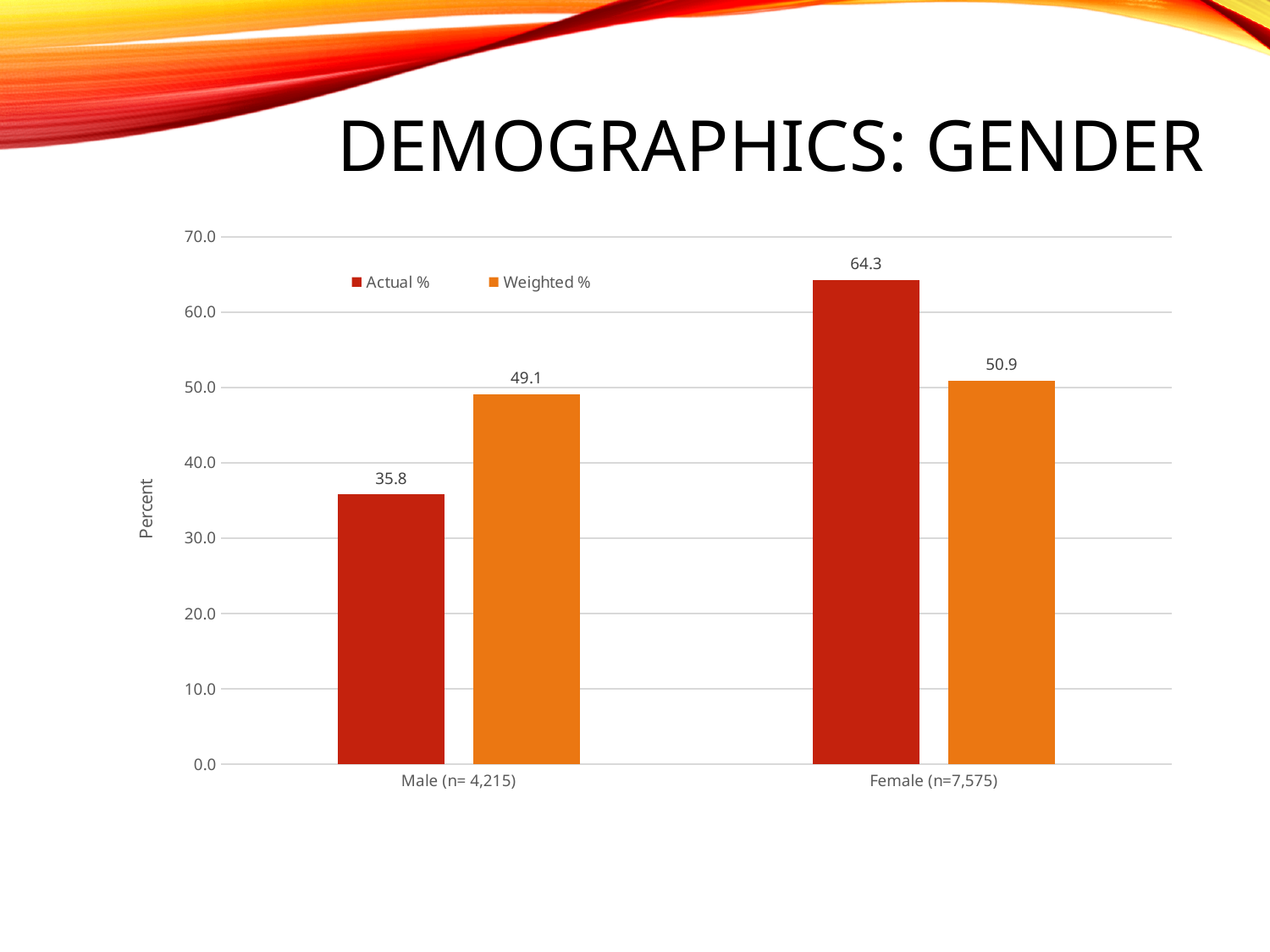
What is the Actual % value for Male (n= 4,215)? 35.8 Which category has the highest Actual % value? Female (n=7,575) What is the Weighted % value for Male (n= 4,215)? 49.1 What is the difference between the Actual % and Weighted % values for Female (n=7,575)? 13.4 What is the difference between the Actual % values for Female (n=7,575) and Male (n= 4,215)? 28.5 What is the Weighted % value for Female (n=7,575)? 50.9 How many series does the legend list? 2 Which is larger for Male (n= 4,215): the Actual % or the Weighted % value? Weighted % Which category has the lowest Weighted % value? Male (n= 4,215) Is the Actual % value for Female (n=7,575) greater or less than 60.0? greater What kind of chart is shown on the slide? Bar chart How many categories are shown on the x axis? 2